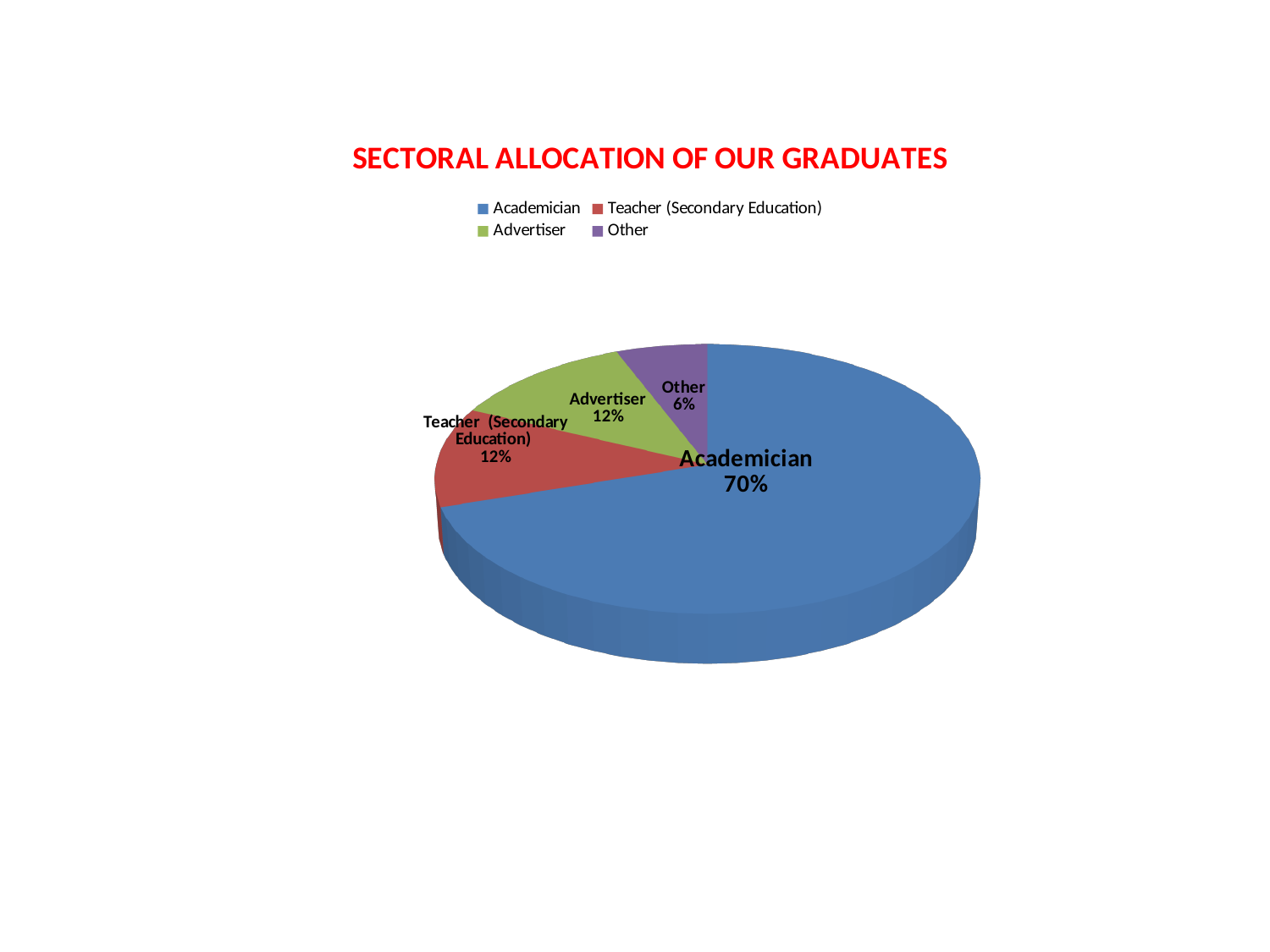
What percentage of graduates are Teachers (Secondary Education)? 12% How many categories are shown in the pie chart? 4 Which is larger, the share for Advertiser or the share for Other? Advertiser Which category has the smallest share of graduates? Other What percentage of graduates are Advertisers? 12% What type of chart is shown on the slide? Pie chart What is the title of the chart? SECTORAL ALLOCATION OF OUR GRADUATES What percentage of graduates are Academicians? 70% What is the difference in percentage points between Academician and Other? 64 Which category has the largest share of graduates? Academician What percentage of graduates are in the Other category? 6% What colour is the Academician slice? Blue